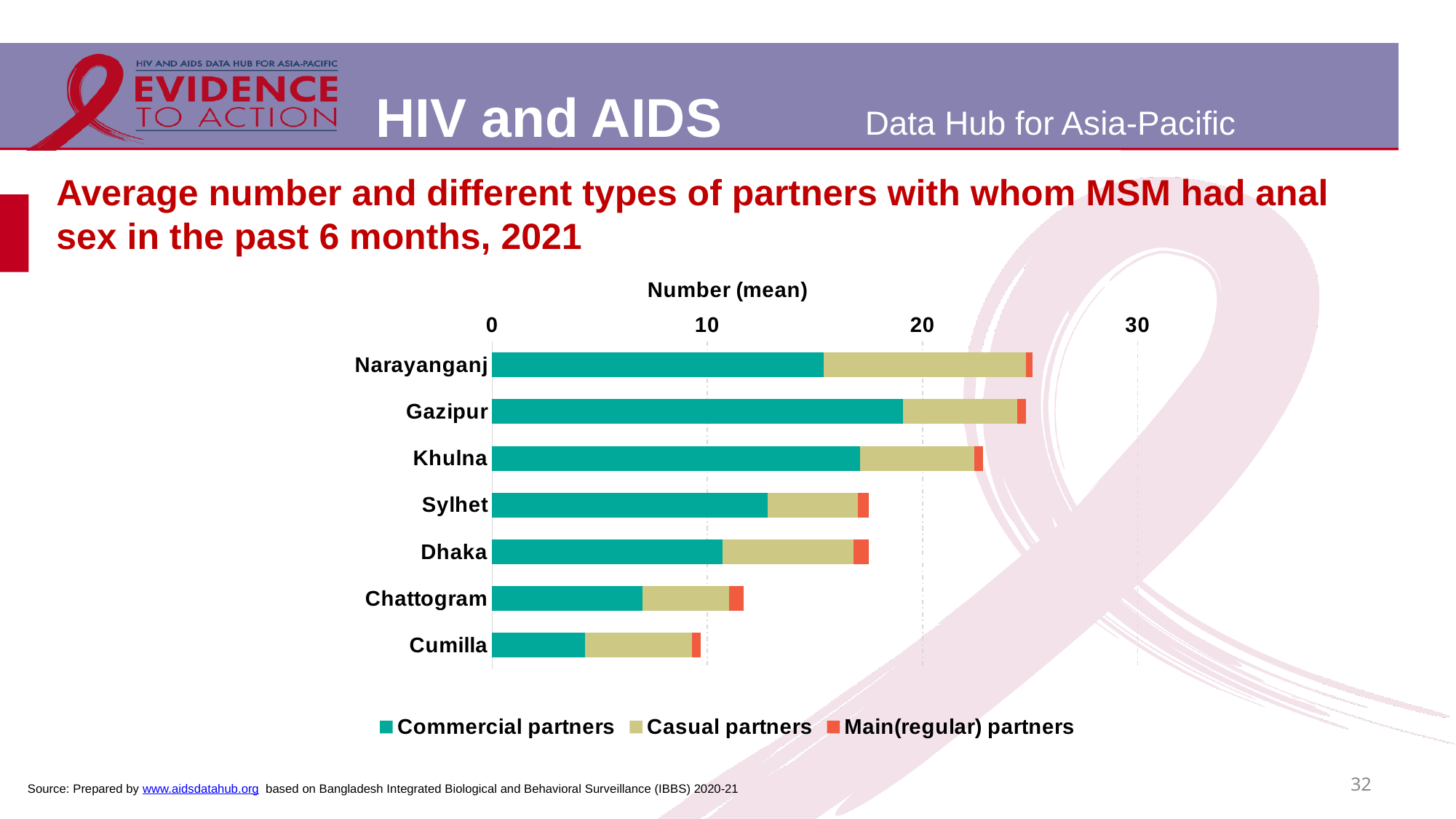
Is the total mean number of partners for Chattogram greater or less than 10? greater What is the label of the horizontal axis? Number (mean) Which has a larger total mean number of partners, Khulna or Sylhet? Khulna How many series does the legend list? 3 What kind of chart is shown on the slide? Bar chart Which city has the lowest total mean number of partners? Cumilla Is the total mean number of partners for Sylhet greater or less than 20? less Which city has the highest mean number of commercial partners? Gazipur Is the mean number of commercial partners for Gazipur greater or less than 20? less How many cities are shown on the chart? 7